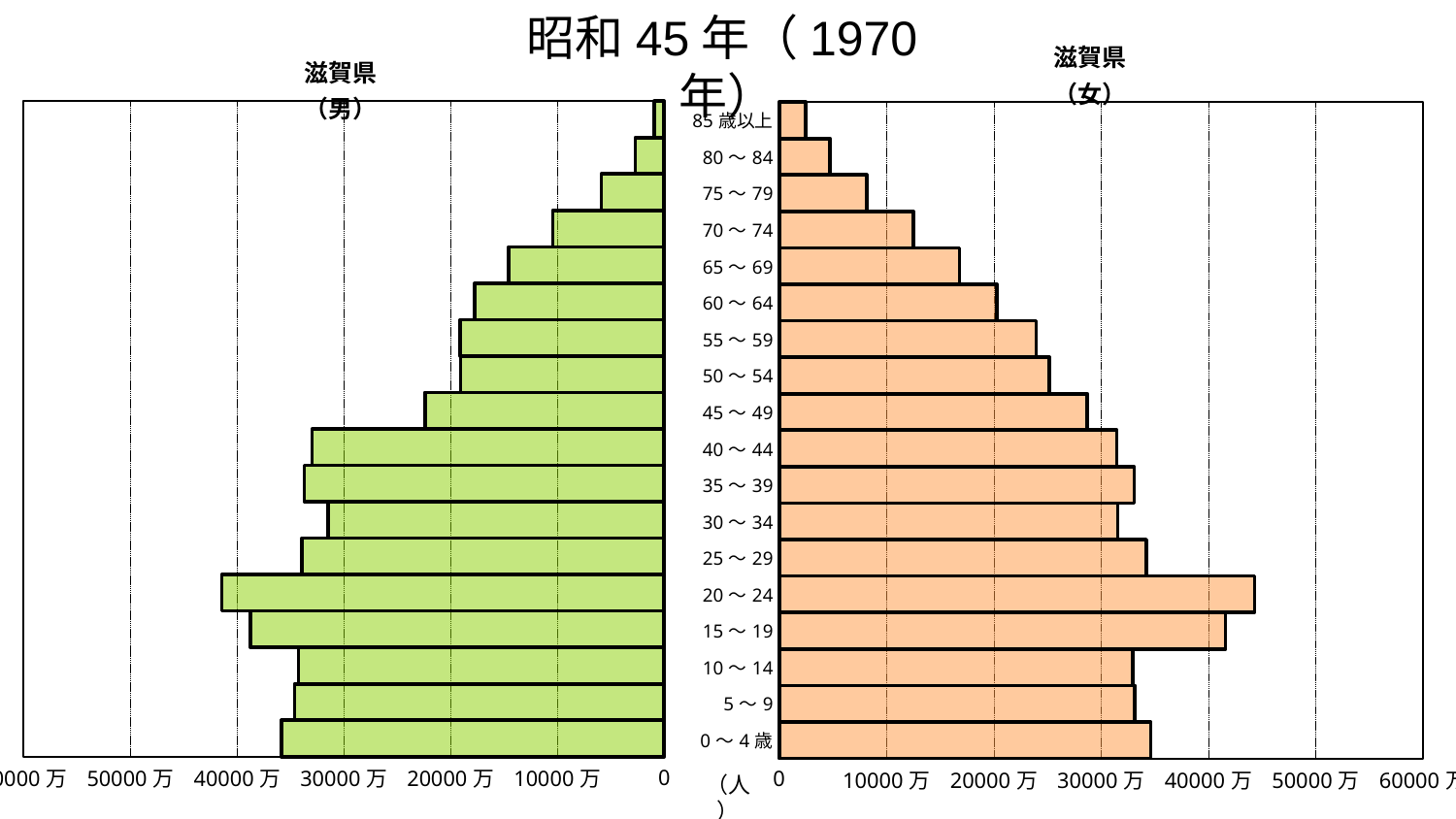
In the 滋賀県（女） chart on the right, which age group has the shortest bar? 85歳以上 In the 滋賀県（男） chart on the left, which age group has the longest bar? 20～24 In the 滋賀県（男） chart on the left, which age group has the shortest bar? 85歳以上 What kind of chart is shown on the slide? bar chart How many age groups are plotted in the 滋賀県（男） chart on the left? 18 In the 滋賀県（女） chart on the right, which is larger, the value for 20～24 or the value for 15～19? 20～24 What is the title shown at the top of the slide? 昭和45年（1970年） In the 滋賀県（女） chart on the right, which age group has the longest bar? 20～24 In the 滋賀県（女） chart on the right, is the value for 45～49 greater or less than 30000万? less In the 滋賀県（男） chart on the left, is the value for 70～74 greater or less than 20000万? less In the 滋賀県（男） chart on the left, which is larger, the value for 45～49 or the value for 40～44? 40～44 In the 滋賀県（男） chart on the left, is the value for 20～24 greater or less than 40000万? greater